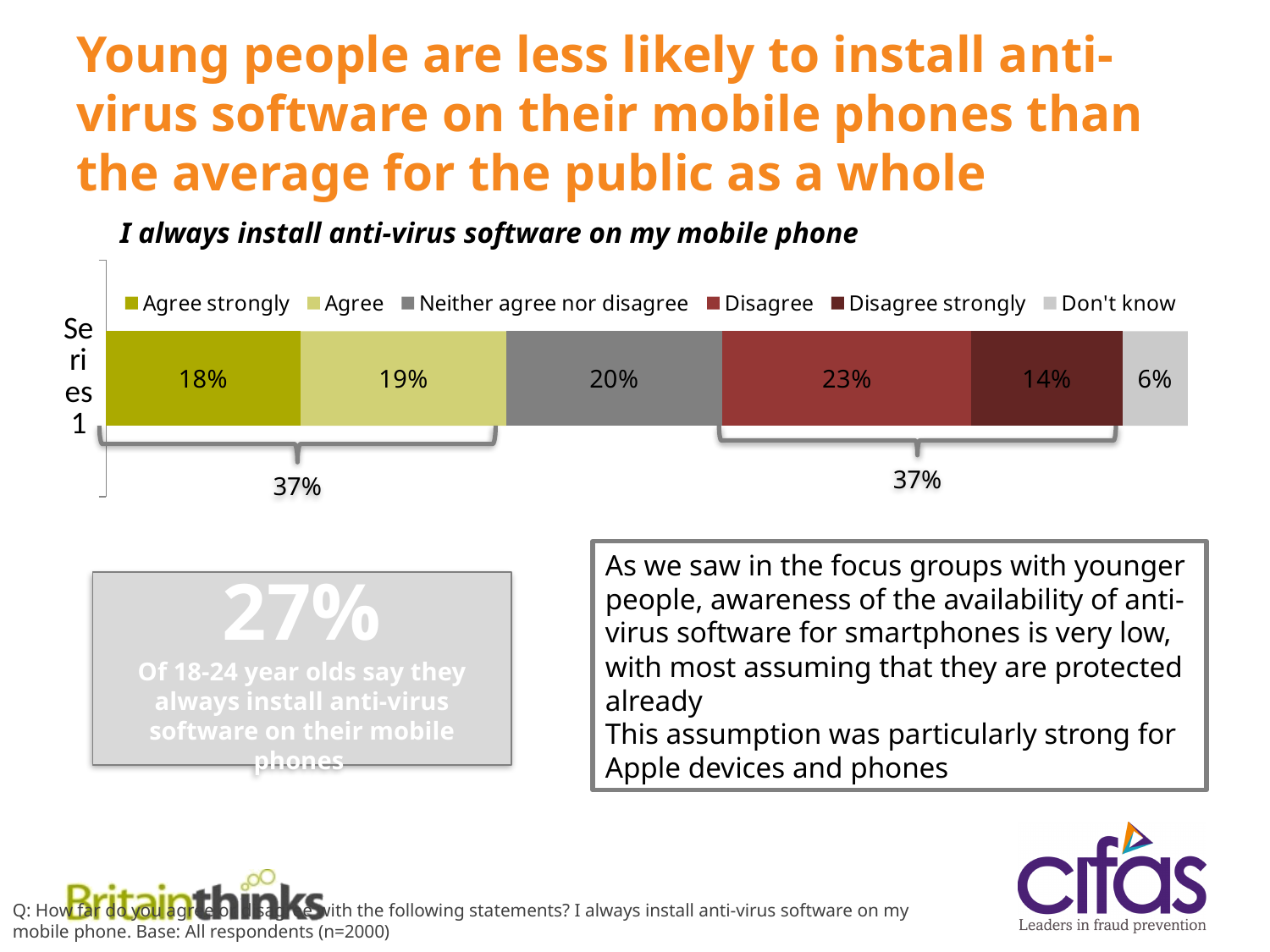
What is the combined share of 'Agree strongly' and 'Agree', as shown by the bracket under the bar? 37% Which response category has the largest share in the bar? Disagree What kind of chart is shown on the slide? Stacked bar chart What is the title of the chart? I always install anti-virus software on my mobile phone What percentage of respondents answered 'Don't know'? 6% Which is larger, the 'Agree' share or the 'Agree strongly' share? Agree What percentage of respondents answered 'Disagree strongly'? 14% How many series does the legend list? 6 What is the difference between the 'Disagree' share and the 'Disagree strongly' share? 9% What percentage of respondents answered 'Neither agree nor disagree'? 20% What percentage of respondents agree strongly that they always install anti-virus software on their mobile phone? 18% Which response category has the smallest share in the bar? Don't know